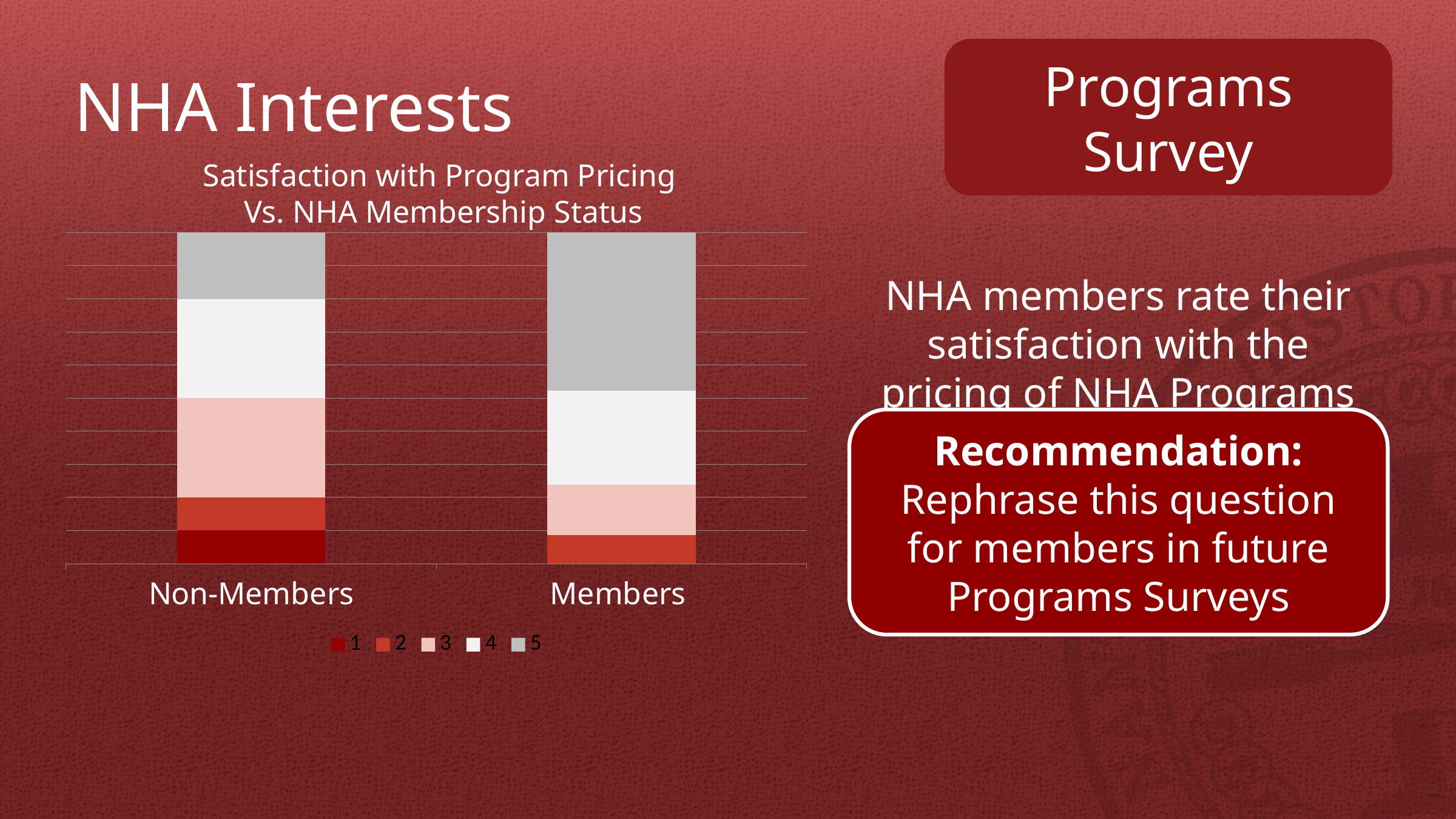
Which series has the largest segment in the Members bar? 5 What is the title of the chart? Satisfaction with Program Pricing Vs. NHA Membership Status What are the two categories on the x axis of the chart? Non-Members and Members Which category has the larger segment for series 1? Non-Members How many series does the chart's legend list? 5 Which category has the larger segment for series 5? Members Which category has the larger segment for series 3? Non-Members How many categories are shown on the x axis of the chart? 2 Which series has the smallest segment in the Members bar? 2 What kind of chart is shown on the slide? Stacked bar chart